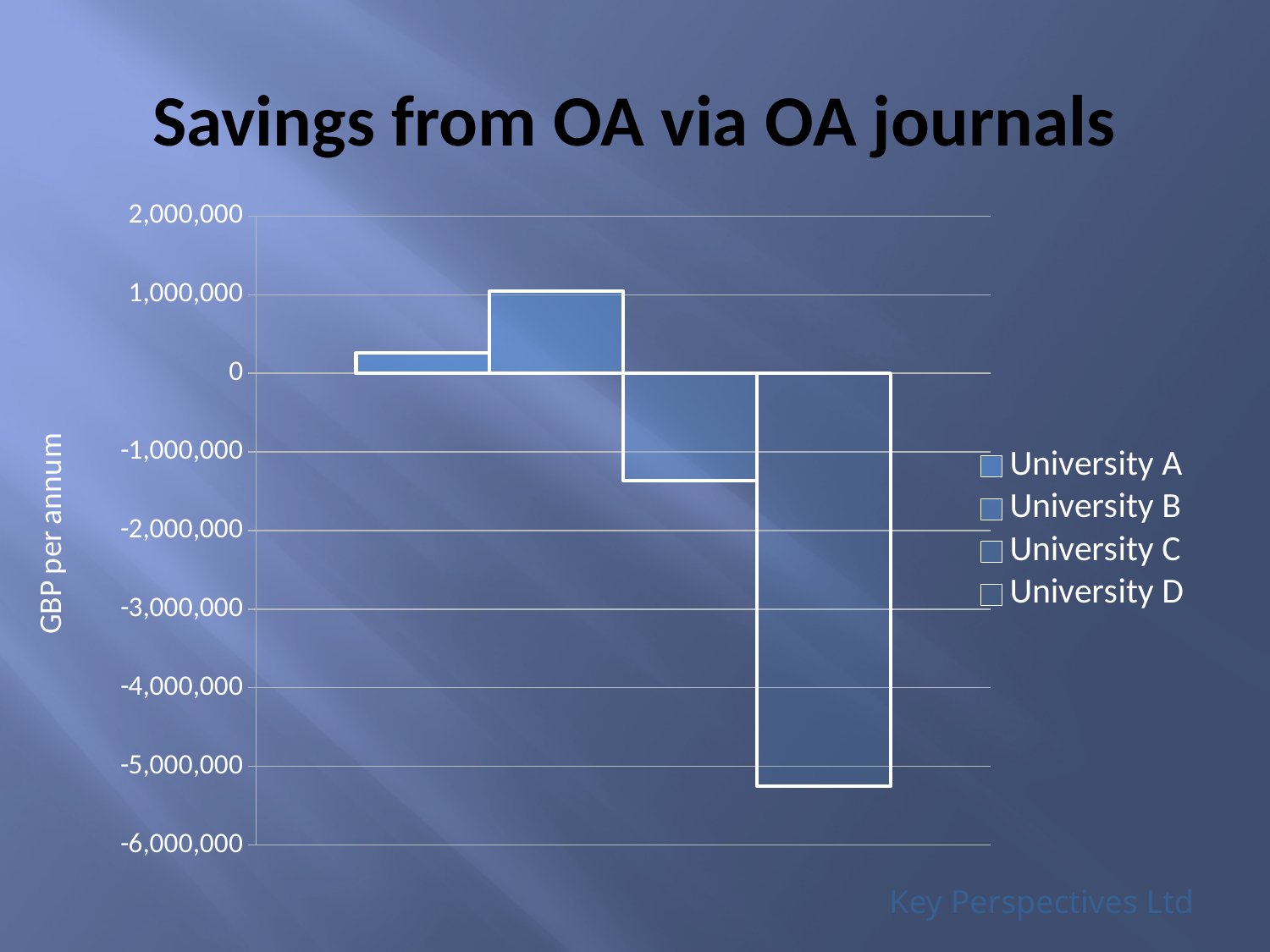
Which is larger, the value for University C or the value for University D? University C How many series does the legend list? 4 Which university has the lowest value? University D Is the value for University D greater or less than -5,000,000? less Is the value for University A greater or less than 1,000,000? less Is the value for University C greater or less than -1,000,000? less Which university has the highest value? University B What kind of chart is shown on the slide? bar chart What is the title of the chart? Savings from OA via OA journals Which is larger, the value for University A or the value for University B? University B What is the label on the vertical axis? GBP per annum